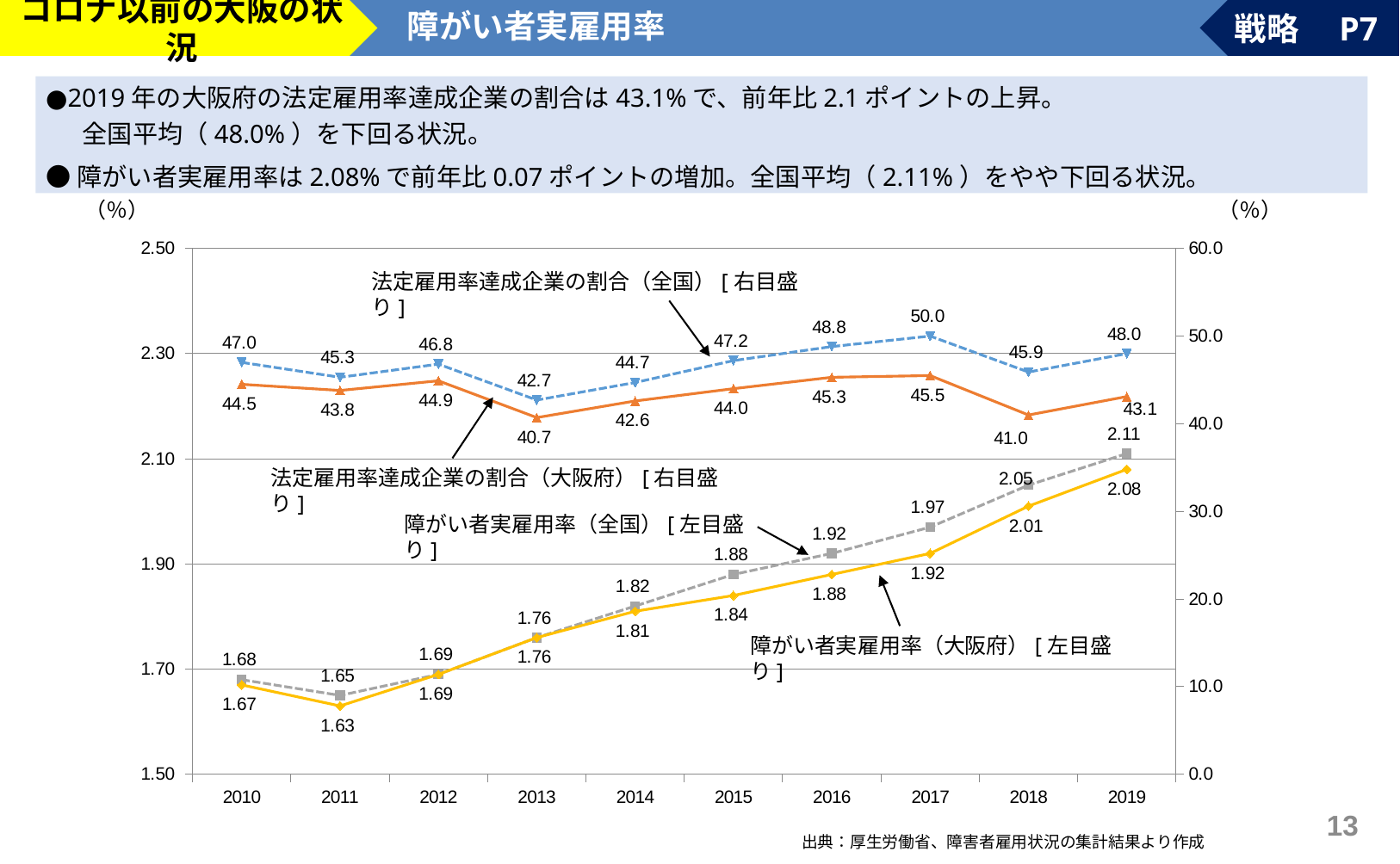
2017年の法定雇用率達成企業の割合（全国）の値はいくつですか？ 50.0 これはどの種類のグラフですか？ 折れ線グラフ 2016年の障がい者実雇用率（全国）の値はいくつですか？ 1.92 法定雇用率達成企業の割合（全国）が最も高いのは何年ですか？ 2017 2018年の障がい者実雇用率は、全国と大阪府のどちらが高いですか？ 全国 2019年の法定雇用率達成企業の割合について、全国と大阪府の差はいくつですか？ 4.9 2013年の法定雇用率達成企業の割合（大阪府）の値はいくつですか？ 40.7 障がい者実雇用率（全国）は2012年から2019年にかけて上昇していますか、下降していますか？ 上昇 2019年の障がい者実雇用率（大阪府）の値はいくつですか？ 2.08 このグラフには何本の系列が描かれていますか？ 4 障がい者実雇用率（大阪府）が最も低いのは何年ですか？ 2011 横軸には何年分のデータ点がありますか？ 10